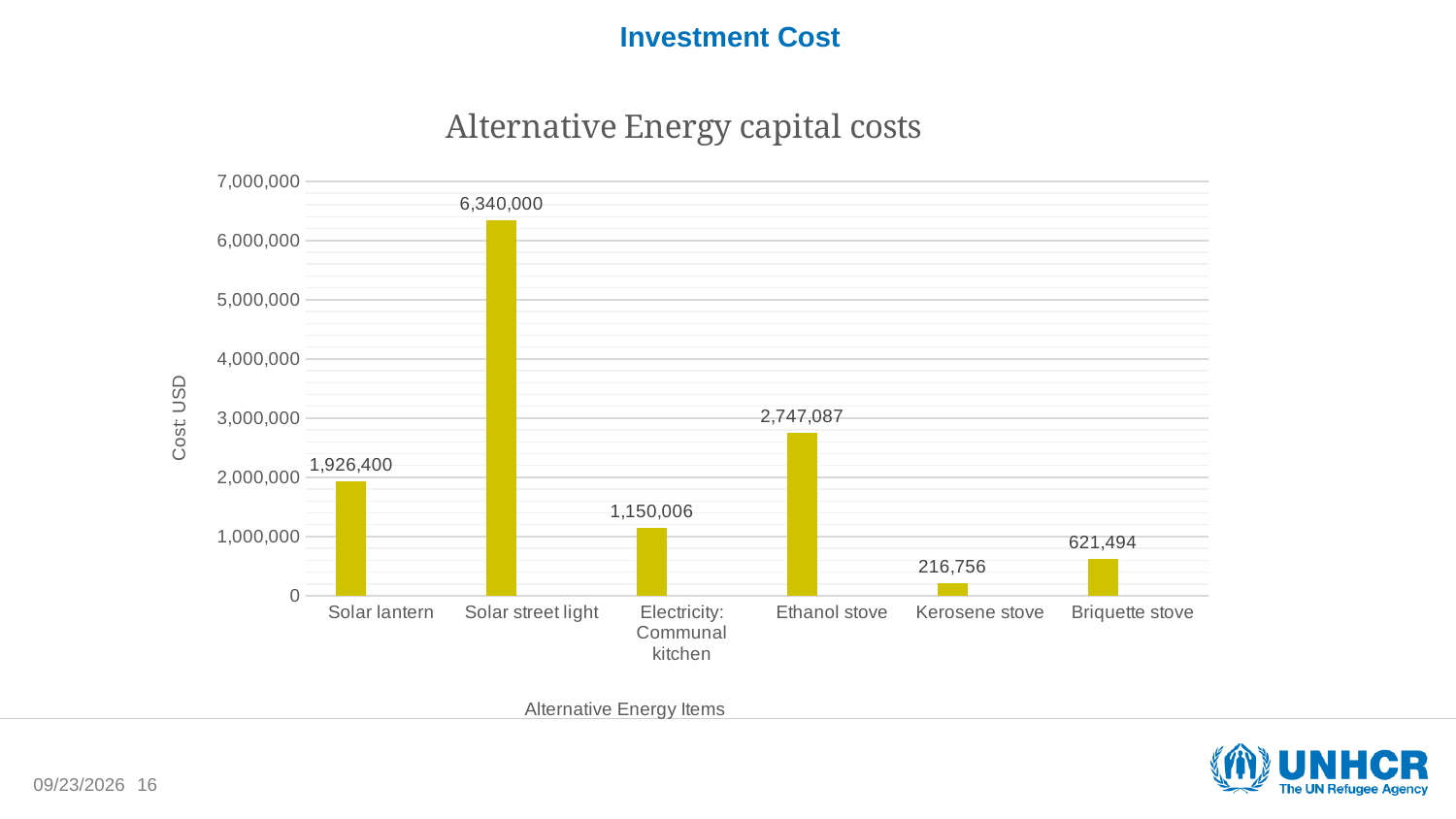
What is the capital cost for Kerosene stove? 216,756 How many alternative energy items are shown in the chart? 6 Which item has the lowest capital cost? Kerosene stove What is the difference in capital cost between Solar street light and Ethanol stove? 3,592,913 What type of chart is shown on the slide? Bar chart Which item has the highest capital cost? Solar street light What is the capital cost for Solar street light? 6,340,000 What is the capital cost for Briquette stove? 621,494 Which has a higher capital cost, Ethanol stove or Solar lantern? Ethanol stove What is the capital cost for Electricity: Communal kitchen? 1,150,006 Is the capital cost for Ethanol stove greater or less than 3,000,000? less What is the difference in capital cost between Solar lantern and Electricity: Communal kitchen? 776,394